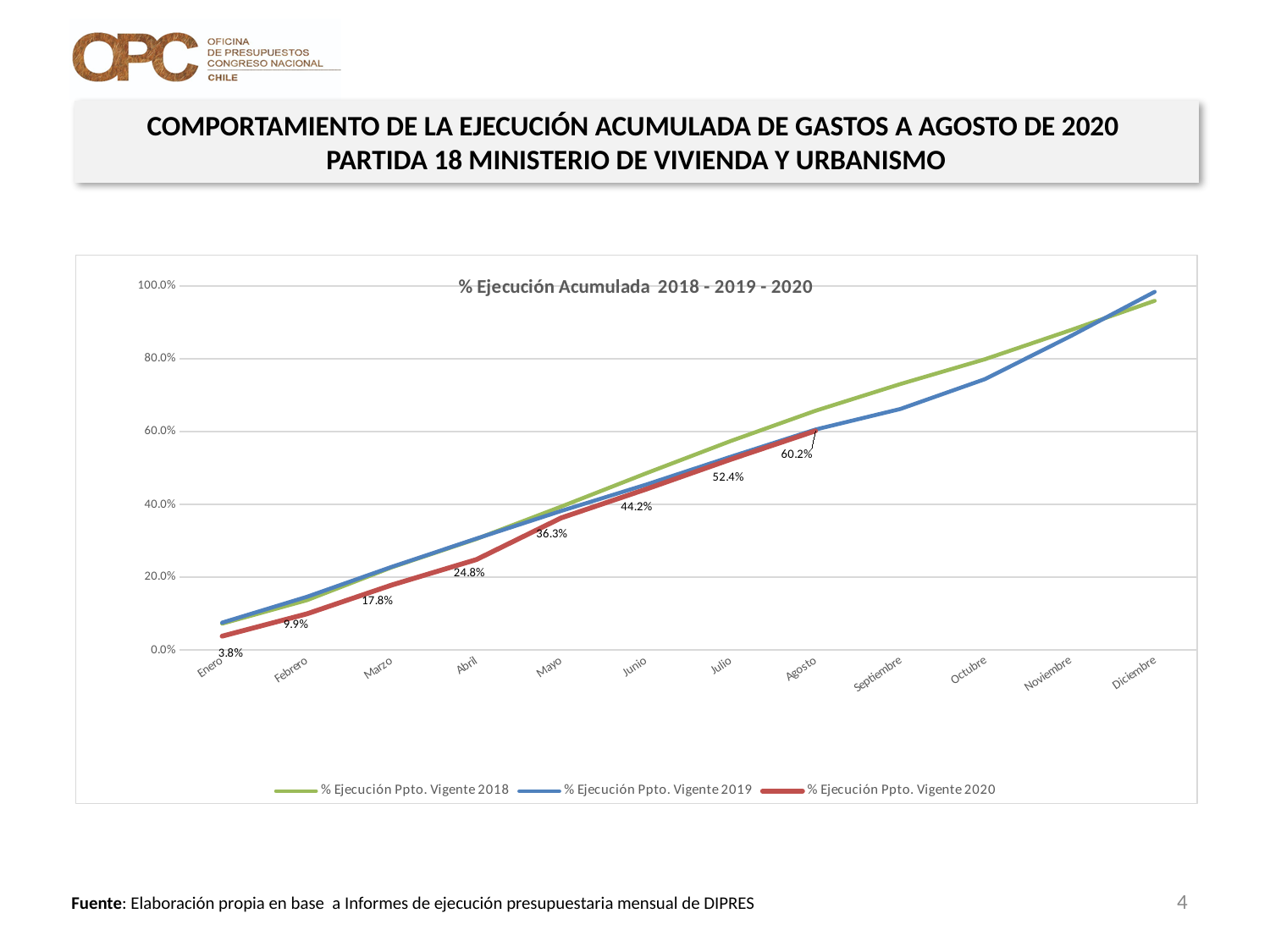
What is the value of % Ejecución Ppto. Vigente 2020 for Mayo? 36.3% Do the values of the 2020 series rise or fall from Enero to Agosto? Rise Which series has the higher value in Octubre, 2018 or 2019? % Ejecución Ppto. Vigente 2018 What is the difference between the 2020 values for Agosto and Julio? 7.8% What is the value of % Ejecución Ppto. Vigente 2020 for Abril? 24.8% What kind of chart is shown on the slide? Line chart What is the value of % Ejecución Ppto. Vigente 2020 for Enero? 3.8% What is the value of % Ejecución Ppto. Vigente 2020 for Agosto? 60.2% How many series does the legend list? 3 How many months are shown on the x axis? 12 Is the value for % Ejecución Ppto. Vigente 2019 in Octubre greater or less than 80.0%? less What is the title of the chart? % Ejecución Acumulada 2018 - 2019 - 2020